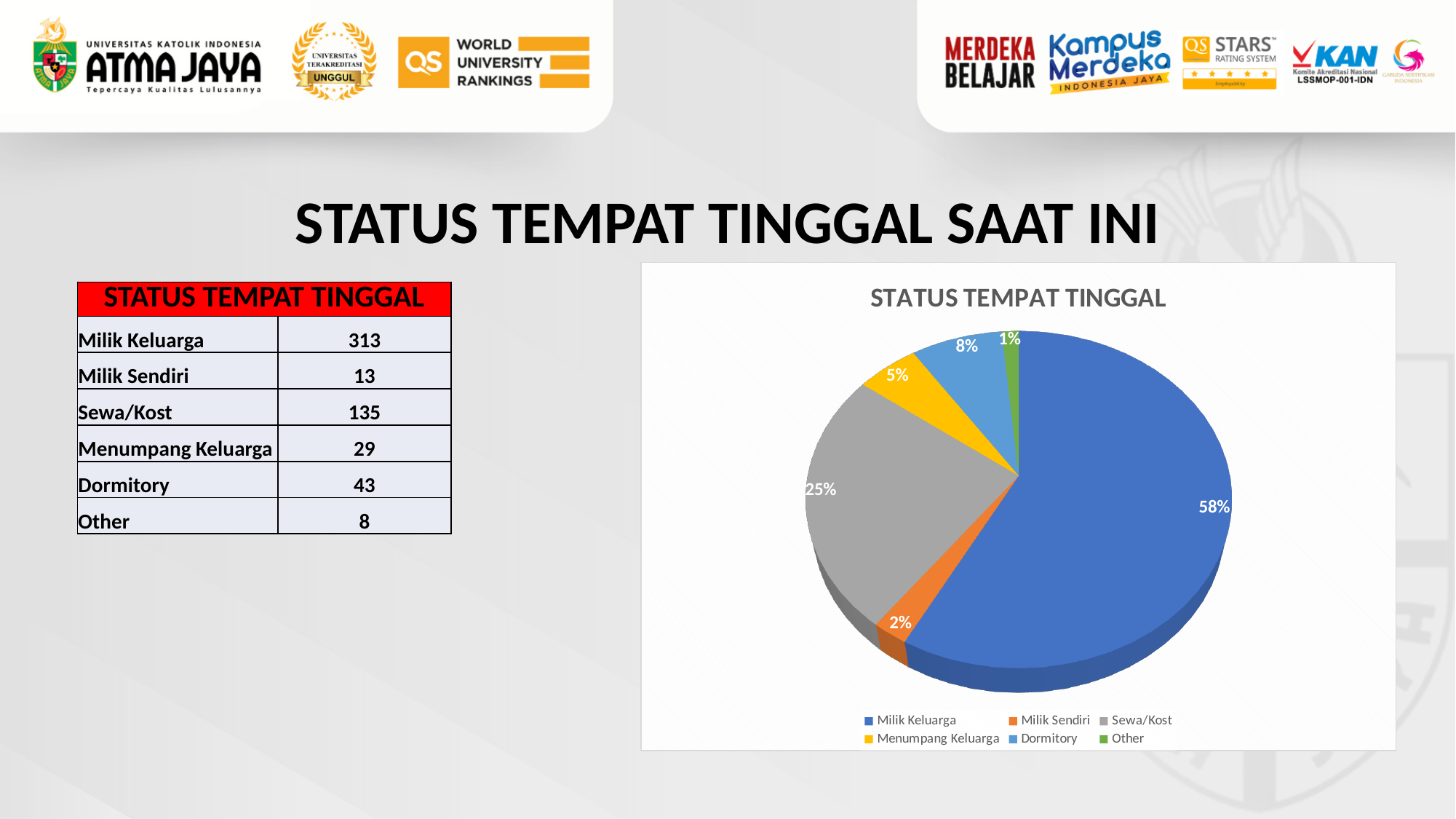
Which category has the largest slice in the pie chart? Milik Keluarga Which category has the smallest slice in the pie chart? Other What share of the pie does Milik Keluarga represent? 58% What percentage is shown for Dormitory in the pie chart? 8% What type of chart is shown on the slide? Pie chart What percentage is shown for Menumpang Keluarga in the pie chart? 5% What share of the pie does Sewa/Kost represent? 25% How many categories does the legend of the pie chart list? 6 Which slice is larger in the pie chart, Dormitory or Menumpang Keluarga? Dormitory What is the title of the chart? STATUS TEMPAT TINGGAL What percentage is shown for Milik Sendiri in the pie chart? 2% What is the difference in percentage points between the Milik Keluarga slice and the Sewa/Kost slice? 33